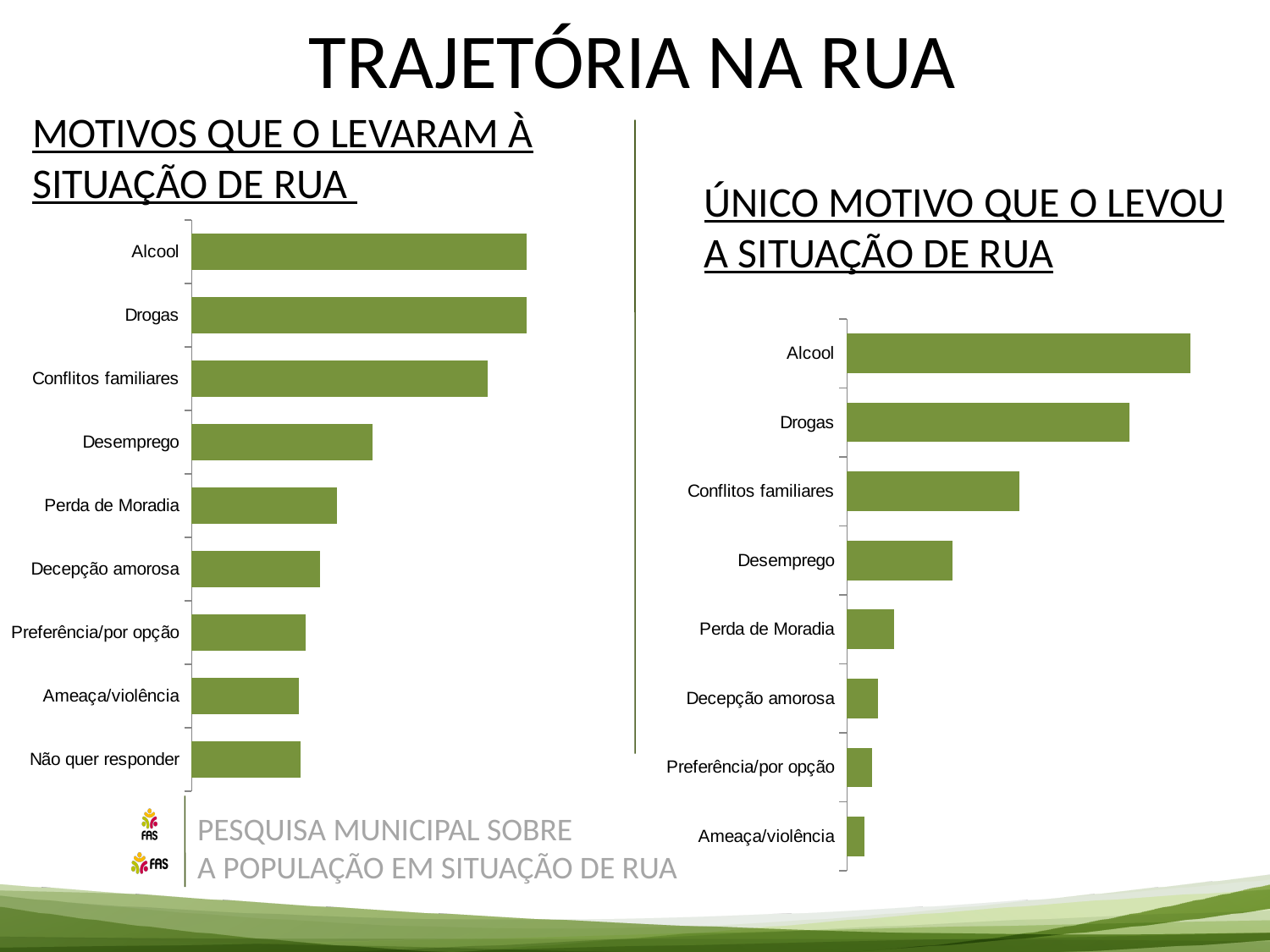
In the right chart, 'ÚNICO MOTIVO QUE O LEVOU A SITUAÇÃO DE RUA', which category has the highest value? Alcool In the right chart, 'ÚNICO MOTIVO QUE O LEVOU A SITUAÇÃO DE RUA', which is larger: Perda de Moradia or Desemprego? Desemprego How many categories are shown in the right chart, 'ÚNICO MOTIVO QUE O LEVOU A SITUAÇÃO DE RUA'? 8 What kind of chart is the right chart, 'ÚNICO MOTIVO QUE O LEVOU A SITUAÇÃO DE RUA'? Bar chart What is the title of the chart on the right side of the slide? ÚNICO MOTIVO QUE O LEVOU A SITUAÇÃO DE RUA In the right chart, 'ÚNICO MOTIVO QUE O LEVOU A SITUAÇÃO DE RUA', which category has the lowest value? Ameaça/violência In the right chart, 'ÚNICO MOTIVO QUE O LEVOU A SITUAÇÃO DE RUA', which is larger: Drogas or Conflitos familiares? Drogas In the left chart, 'MOTIVOS QUE O LEVARAM À SITUAÇÃO DE RUA', which is larger: Conflitos familiares or Desemprego? Conflitos familiares How many categories are shown in the left chart, 'MOTIVOS QUE O LEVARAM À SITUAÇÃO DE RUA'? 9 What kind of chart is the left chart, 'MOTIVOS QUE O LEVARAM À SITUAÇÃO DE RUA'? Bar chart Which category appears in the left chart, 'MOTIVOS QUE O LEVARAM À SITUAÇÃO DE RUA', but not in the right chart? Não quer responder